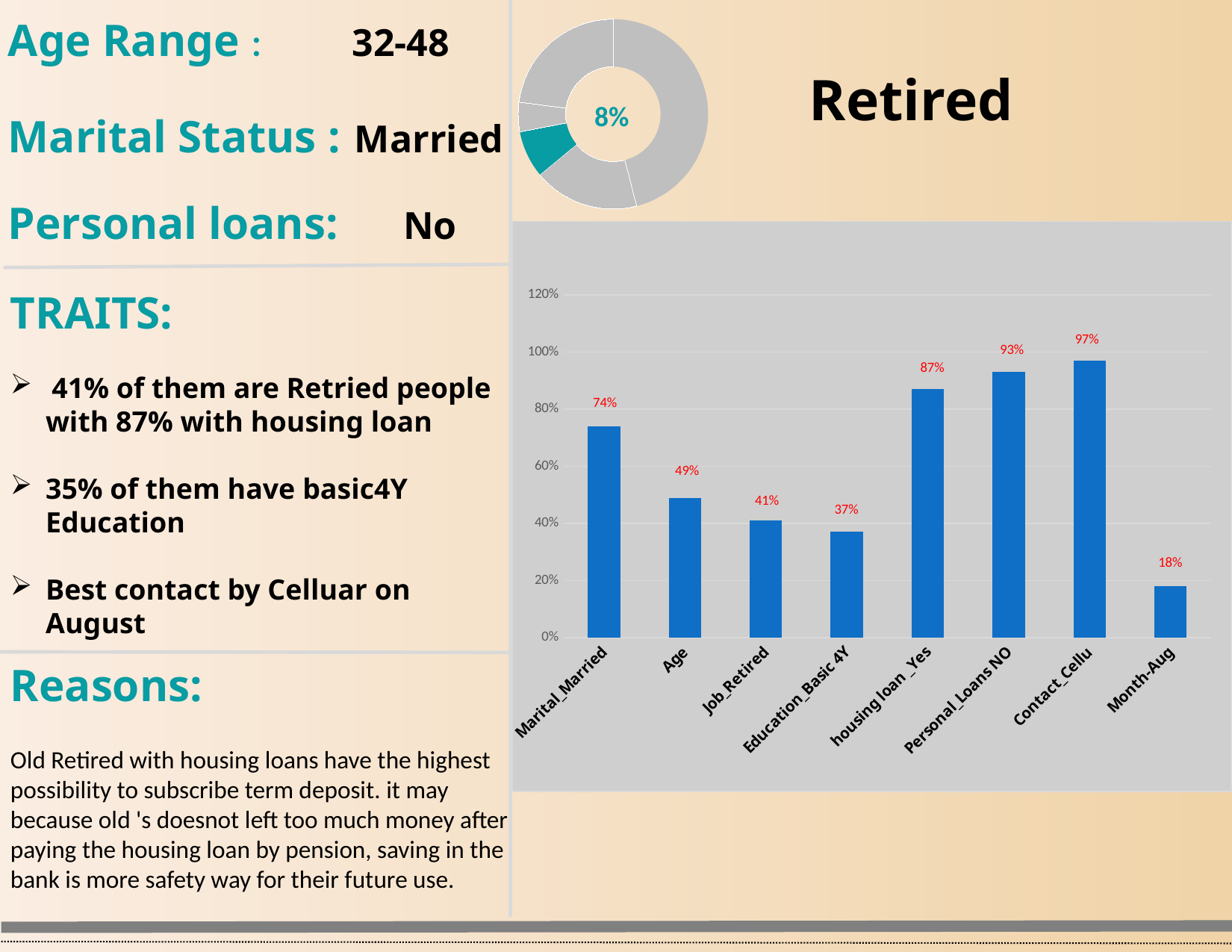
In the bar chart, what is the difference between the values for Personal_Loans NO and housing loan_Yes? 6% In the bar chart, which category has the lowest value? Month-Aug In the donut chart at the top of the slide, what share does the highlighted teal slice represent? 8% In the bar chart, which category has the highest value? Contact_Cellu In the bar chart, what is the value for Month-Aug? 18% What kind of chart is the chart at the top of the slide next to the word Retired? donut chart How many categories are shown in the bar chart? 8 In the bar chart, is the value for Job_Retired greater or less than 60%? less In the bar chart, what is the value for Education_Basic 4Y? 37% What kind of chart is the chart at the bottom right of the slide? bar chart In the bar chart, which is larger: the value for Marital_Married or the value for Age? Marital_Married In the bar chart, what is the value for Contact_Cellu? 97%